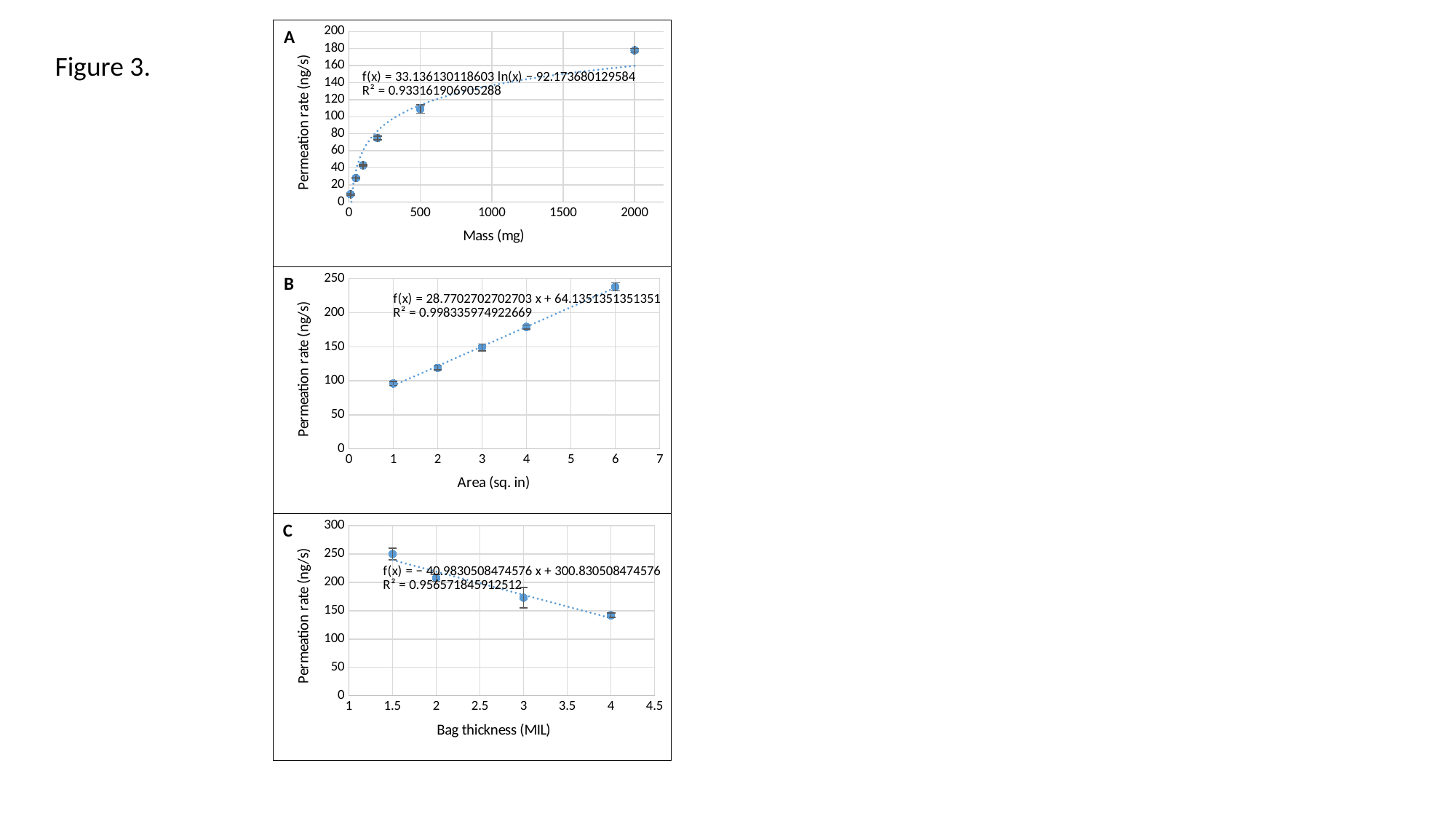
In chart B, how many data points are plotted? 5 What is the x-axis label of chart C? Bag thickness (MIL) In chart B, does the permeation rate rise or fall as area increases? rise What kind of chart is chart A? scatter chart In chart C, does the permeation rate rise or fall as bag thickness increases? fall In chart A, does the permeation rate rise or fall as mass increases? rise In chart A, how many data points are plotted? 6 In chart B, at which area is the permeation rate highest? 6 sq. in In chart C, is the permeation rate at 4 MIL greater or less than 150? less In chart A, is the permeation rate at 2000 mg greater or less than 160? greater In chart C, how many data points are plotted? 4